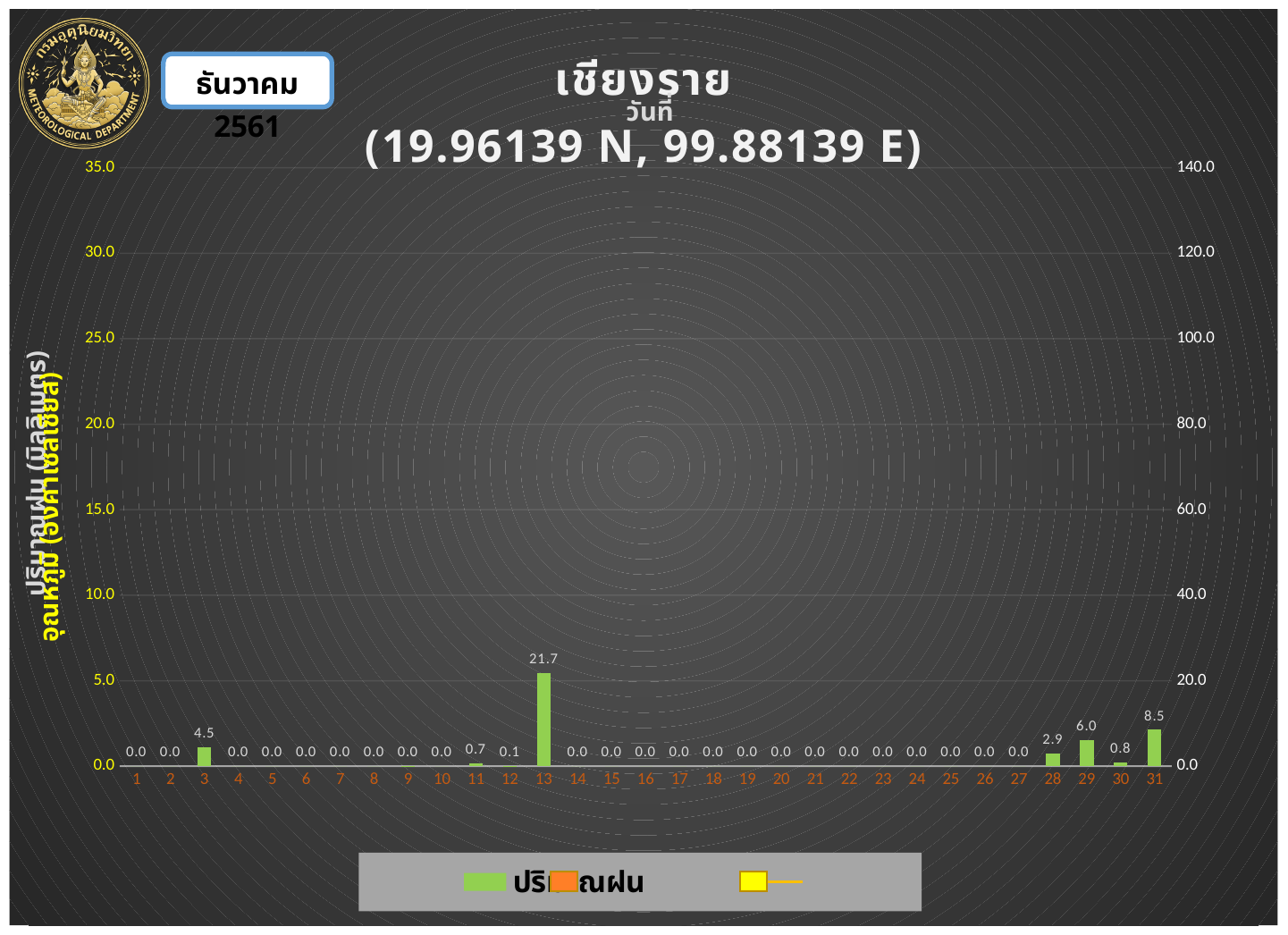
What is the rainfall value shown for day 31? 8.5 What is the rainfall value shown for day 3? 4.5 Which day has the highest rainfall value? 13 What kind of chart is used to show the rainfall values? bar chart What is the difference between the rainfall values for day 31 and day 29? 2.5 What is the rainfall value shown for day 13? 21.7 What coordinates are shown in the chart title? (19.96139 N, 99.88139 E) What is the rainfall value shown for day 11? 0.7 How many days are shown on the x axis of the chart? 31 Which day has the larger rainfall value, day 28 or day 29? 29 What is the rainfall value shown for day 12? 0.1 What is the difference between the rainfall values for day 13 and day 31? 13.2